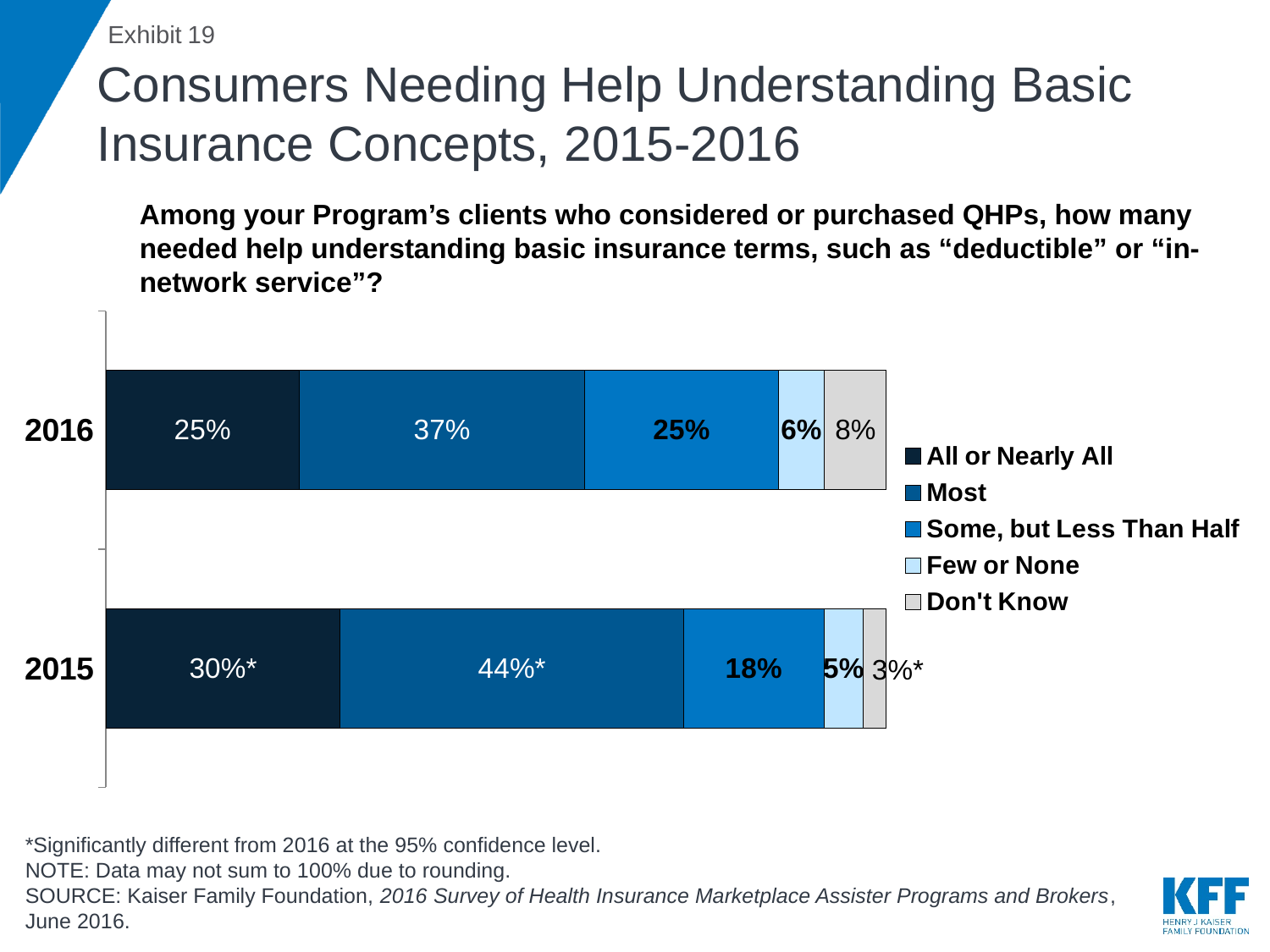
What is the value for "Don't Know" in 2016? 8% What is the value for "All or Nearly All" in 2015? 30% Which legend entry is shown in the lightest blue colour? Few or None Which response category has the smallest share in the 2016 bar? Few or None How many series does the legend list? 5 What percentage of assister programs said "Most" clients needed help in 2016? 37% What type of chart is shown on the slide? stacked bar chart Is the "Some, but Less Than Half" share larger in 2016 or in 2015? 2016 Which response category has the largest share in the 2015 bar? Most By how many percentage points did the "Most" share change from 2015 to 2016? 7 percentage points How many years (bars) are shown in the chart? 2 What is the value for "Some, but Less Than Half" in 2015? 18%